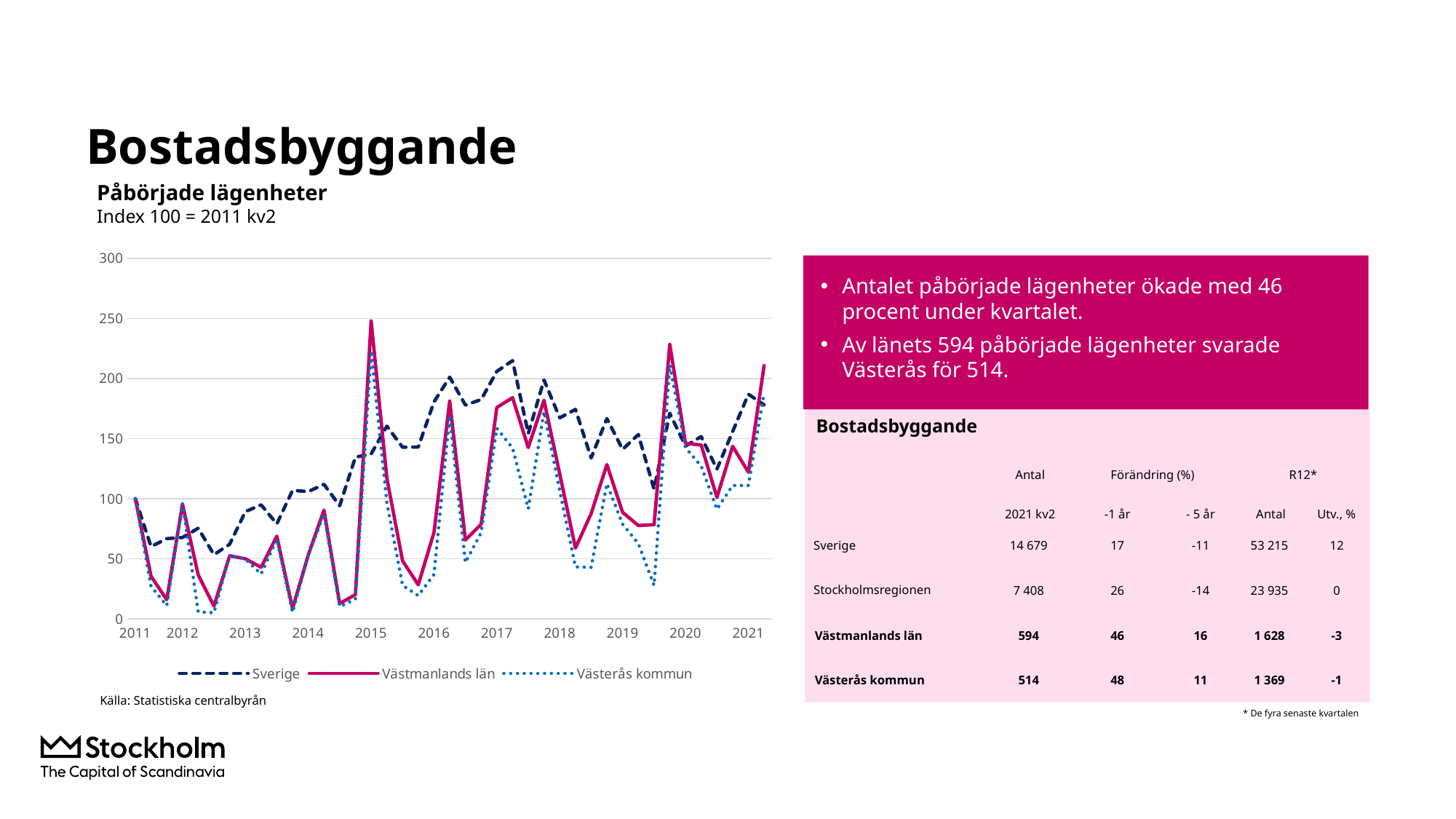
Does the Sverige series generally rise or fall between 2011 and 2017? rise Is the peak value for Västmanlands län in 2015 greater or less than 200? greater Is the peak value for Sverige in 2017 greater or less than 200? greater What is the title of the chart? Påbörjade lägenheter What kind of chart is shown on the slide? Line chart Is the value for Västmanlands län at the last point in 2021 greater or less than 200? greater How many series does the chart legend list? 3 What index value do all three series have at 2011 kv2? 100 In which year does Västmanlands län reach its highest value on the chart? 2015 How many year labels are shown on the x axis? 11 What source is cited below the chart? Statistiska centralbyrån